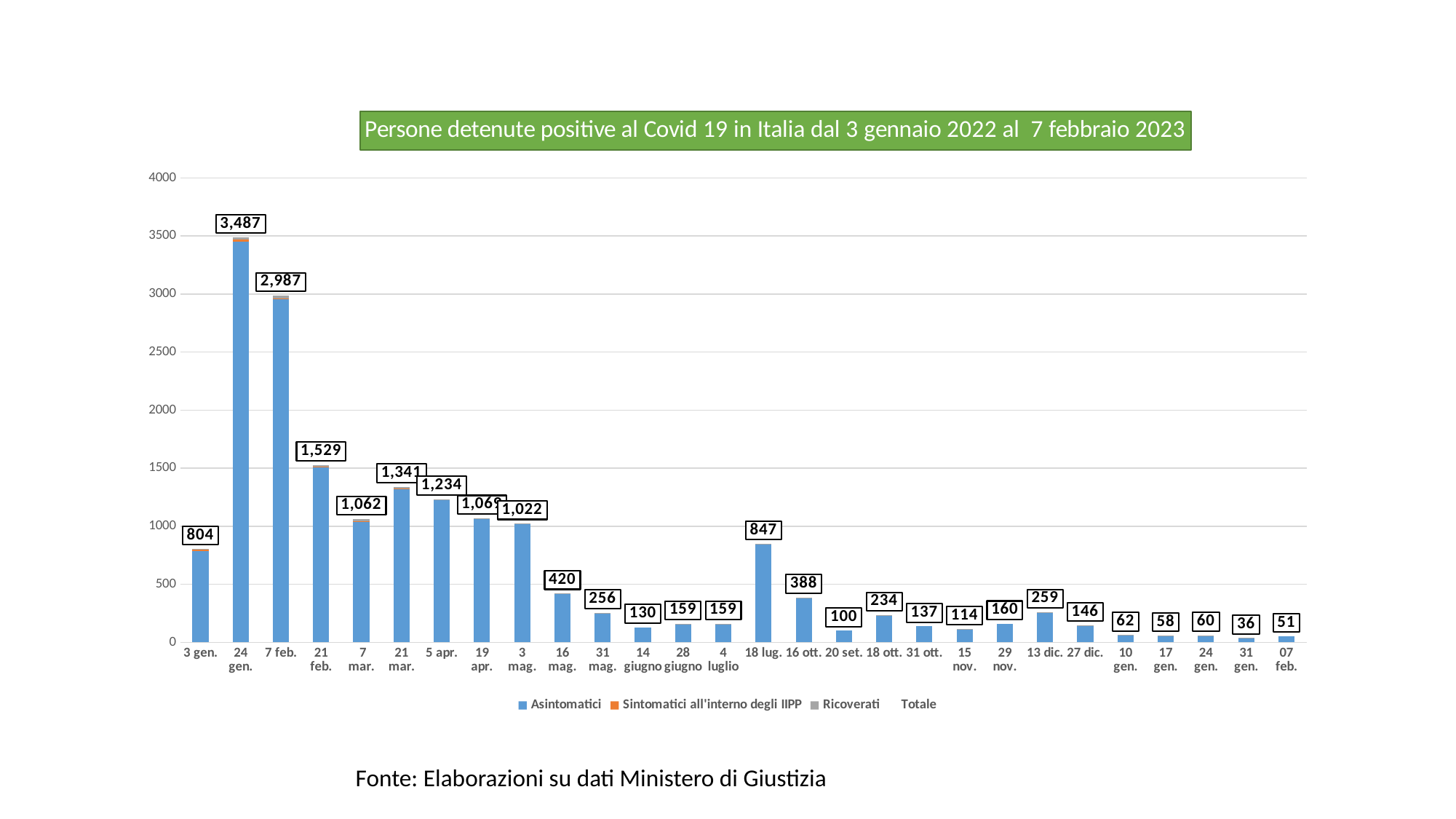
How many dates (bars) are shown on the x axis? 28 What is the difference between the totals for 16 mag. and 31 mag.? 164 What is the total value labelled on the bar for 21 feb.? 1,529 What is the difference between the highest total (3,487) and the total for 7 feb. (2,987)? 500 What is the total value labelled on the bar for 7 feb.? 2,987 How many series does the legend list? 4 Which date has the highest total of positive detainees? 24 gen. (2022) Which date has the lowest total of positive detainees? 31 gen. What kind of chart is shown on the slide? Stacked bar chart What is the total value labelled on the last bar, 07 feb.? 51 Which has a larger total, 16 ott. or 13 dic.? 16 ott. What is the total value labelled on the bar for 18 lug.? 847